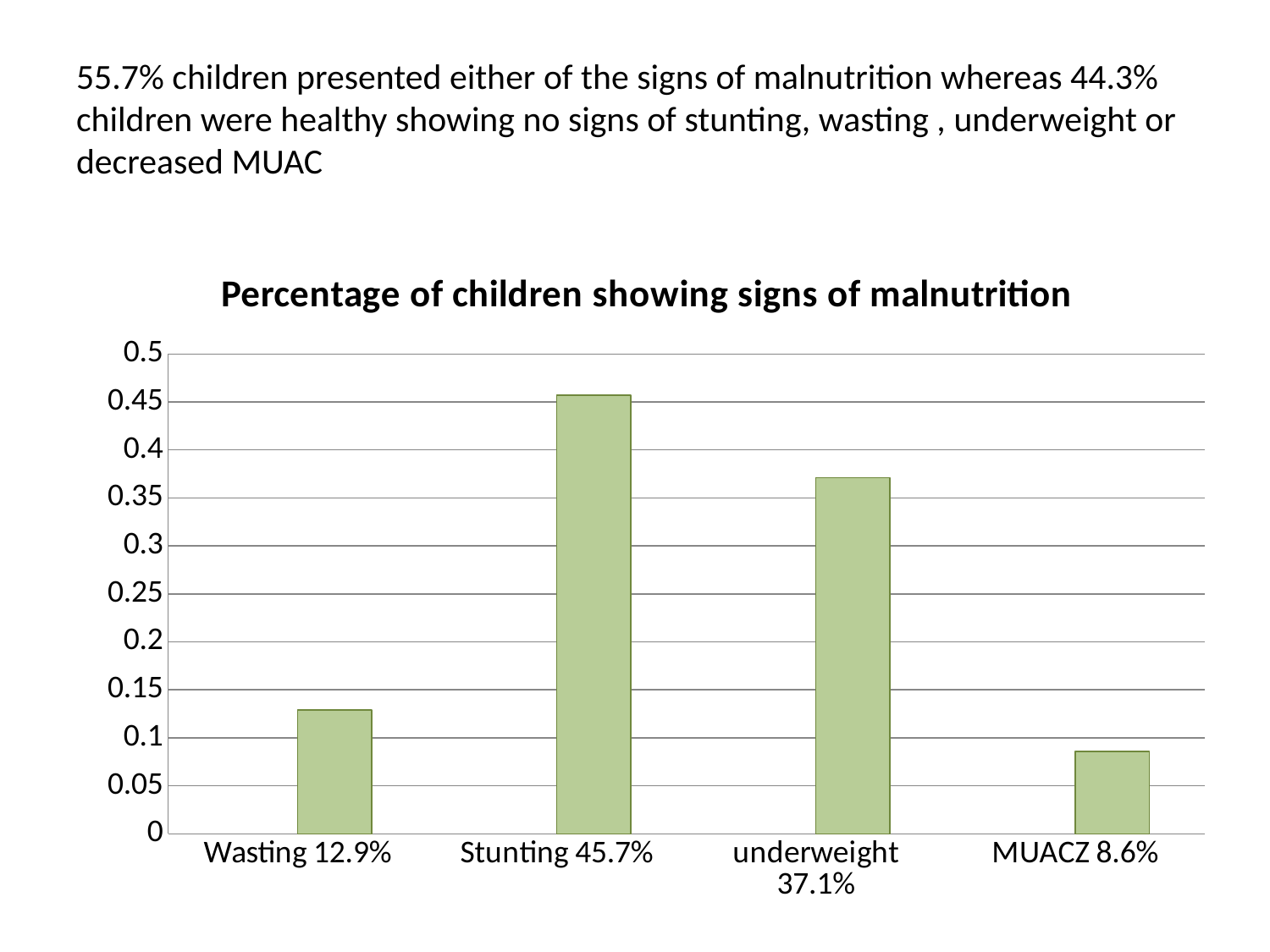
What is the difference in percentage points between Stunting and underweight? 8.6% What type of chart is shown on the slide? bar chart Which sign of malnutrition has the lowest bar? MUACZ Is the bar for Stunting greater or less than 0.4 on the y axis? greater Which is larger, the value for Wasting or the value for underweight? underweight What percentage of children were underweight, according to the category label? 37.1% What percentage of children showed signs of wasting, according to the category label? 12.9% Which sign of malnutrition has the highest bar? Stunting How many categories are plotted in the chart? 4 What percentage of children showed signs of stunting, according to the category label? 45.7% What percentage is given for MUACZ in the category label? 8.6% What is the title of the chart? Percentage of children showing signs of malnutrition